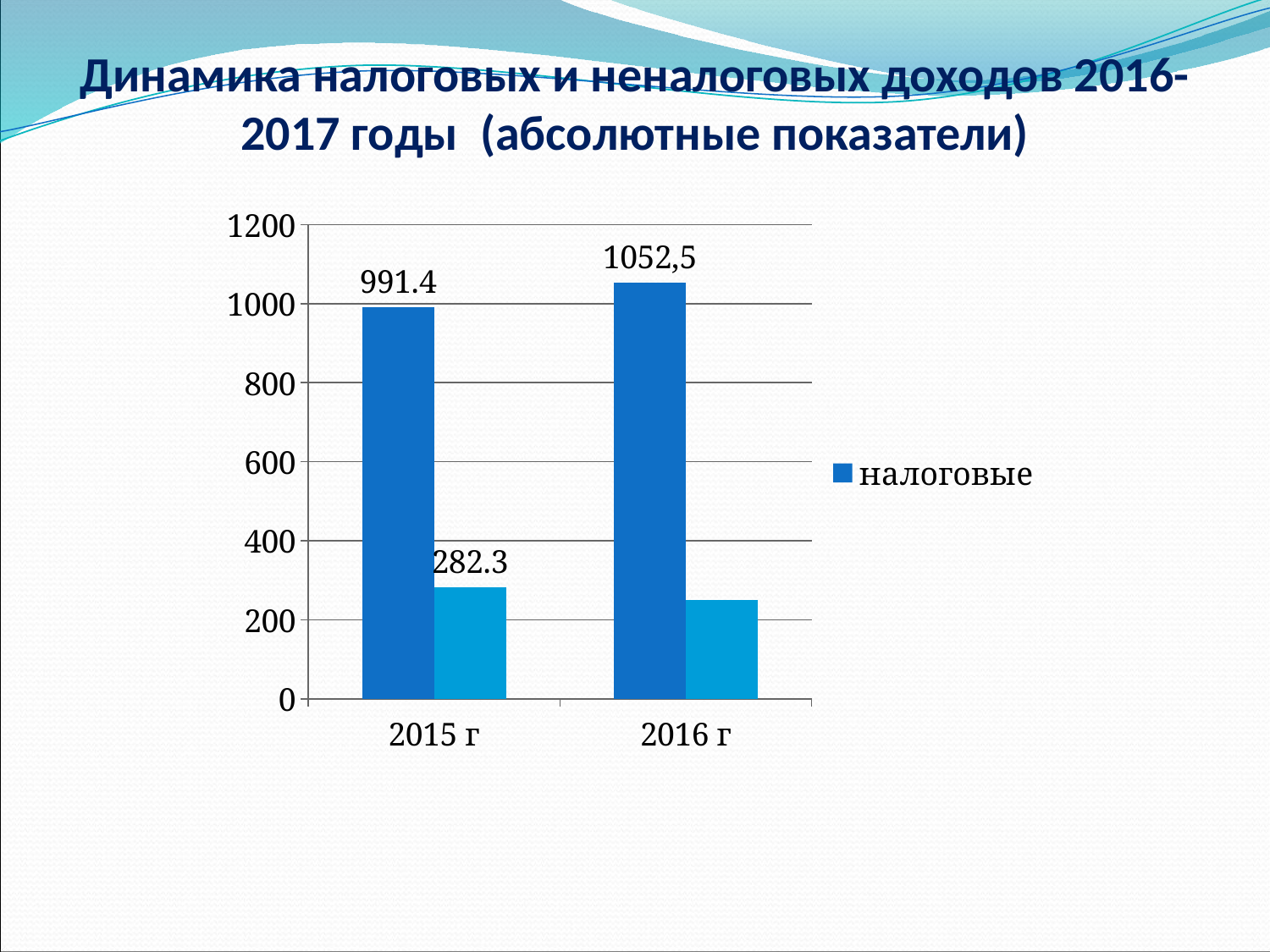
Do the налоговые values rise or fall from 2015 г to 2016 г? rise How many series does the legend list? 1 What is the difference between the налоговые bar and the lighter blue bar for 2015 г? 709.1 What is the value of the налоговые bar for 2015 г? 991.4 Which year has the larger налоговые value, 2015 г or 2016 г? 2016 г What kind of chart is shown on the slide? bar chart Is the налоговые value for 2016 г greater or less than 1000? greater Is the value of the lighter blue bar for 2016 г greater or less than 400? less What is the value of the налоговые bar for 2016 г? 1052,5 How many year categories are shown on the x axis? 2 What value is labelled on the lighter blue bar for 2015 г? 282.3 By how much does the налоговые value for 2016 г exceed the value for 2015 г? 61.1